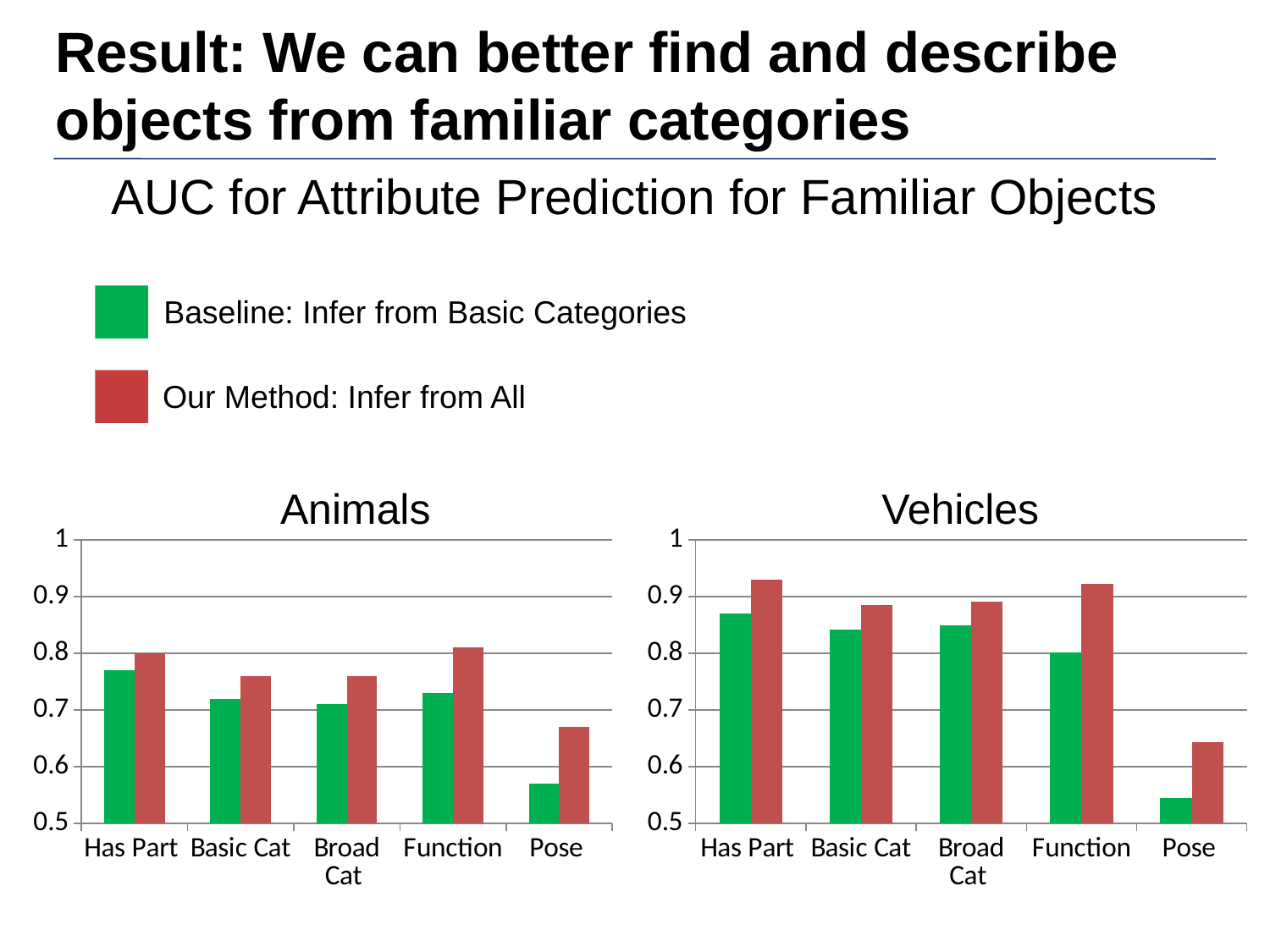
In the Vehicles chart, is the Our Method value for Has Part greater or less than 0.9? greater In the Vehicles chart, which category has the lowest value for Our Method: Infer from All? Pose In the Vehicles chart, for Pose, which is larger: Baseline or Our Method? Our Method In the Animals chart, is the Baseline value for Pose greater or less than 0.6? less In the Animals chart, for Function, which is larger: Baseline or Our Method? Our Method In the Animals chart, which category has the highest value for Baseline: Infer from Basic Categories? Has Part What colour represents Our Method: Infer from All in the legend? red How many series does the legend list? 2 In the Vehicles chart, is the Baseline value for Pose greater or less than 0.6? less In the Animals chart, which category has the lowest value for Baseline: Infer from Basic Categories? Pose How many categories are shown on the x axis of the Vehicles chart? 5 What kind of chart is the Animals chart? bar chart